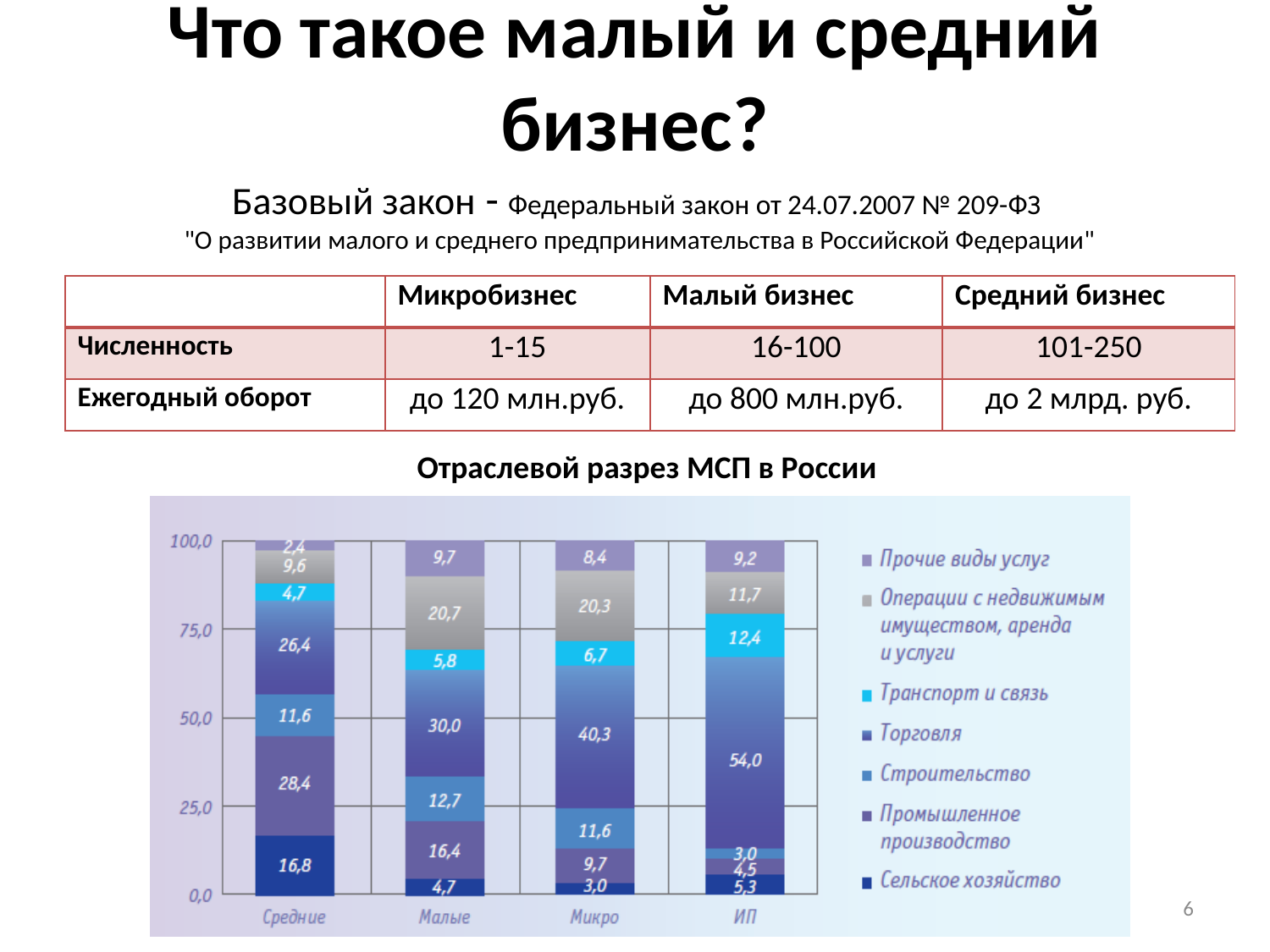
In the chart 'Отраслевой разрез МСП в России', which series is shown at the top of each stacked bar according to the legend? Прочие виды услуг In the chart 'Отраслевой разрез МСП в России', which is larger: 'Промышленное производство' for 'Средние' or for 'Малые'? Средние How many categories (bars) are shown on the x axis of the chart 'Отраслевой разрез МСП в России'? 4 In the chart 'Отраслевой разрез МСП в России', what is the value of 'Транспорт и связь' for the 'Микро' bar? 6,7 In the chart 'Отраслевой разрез МСП в России', which bar has the highest value for 'Торговля'? ИП In the chart 'Отраслевой разрез МСП в России', what is the value of 'Торговля' for the 'ИП' bar? 54,0 How many series does the legend of the chart 'Отраслевой разрез МСП в России' list? 7 In the chart 'Отраслевой разрез МСП в России', which bar has the lowest value for 'Сельское хозяйство'? Микро In the chart 'Отраслевой разрез МСП в России', what is the difference between the 'Торговля' values for 'Микро' and 'Малые'? 10,3 In the chart 'Отраслевой разрез МСП в России', what is the value of 'Операции с недвижимым имуществом, аренда и услуги' for the 'Малые' bar? 20,7 In the chart 'Отраслевой разрез МСП в России', what is the value of 'Сельское хозяйство' for the 'Средние' bar? 16,8 What kind of chart is shown under the heading 'Отраслевой разрез МСП в России'? stacked bar chart